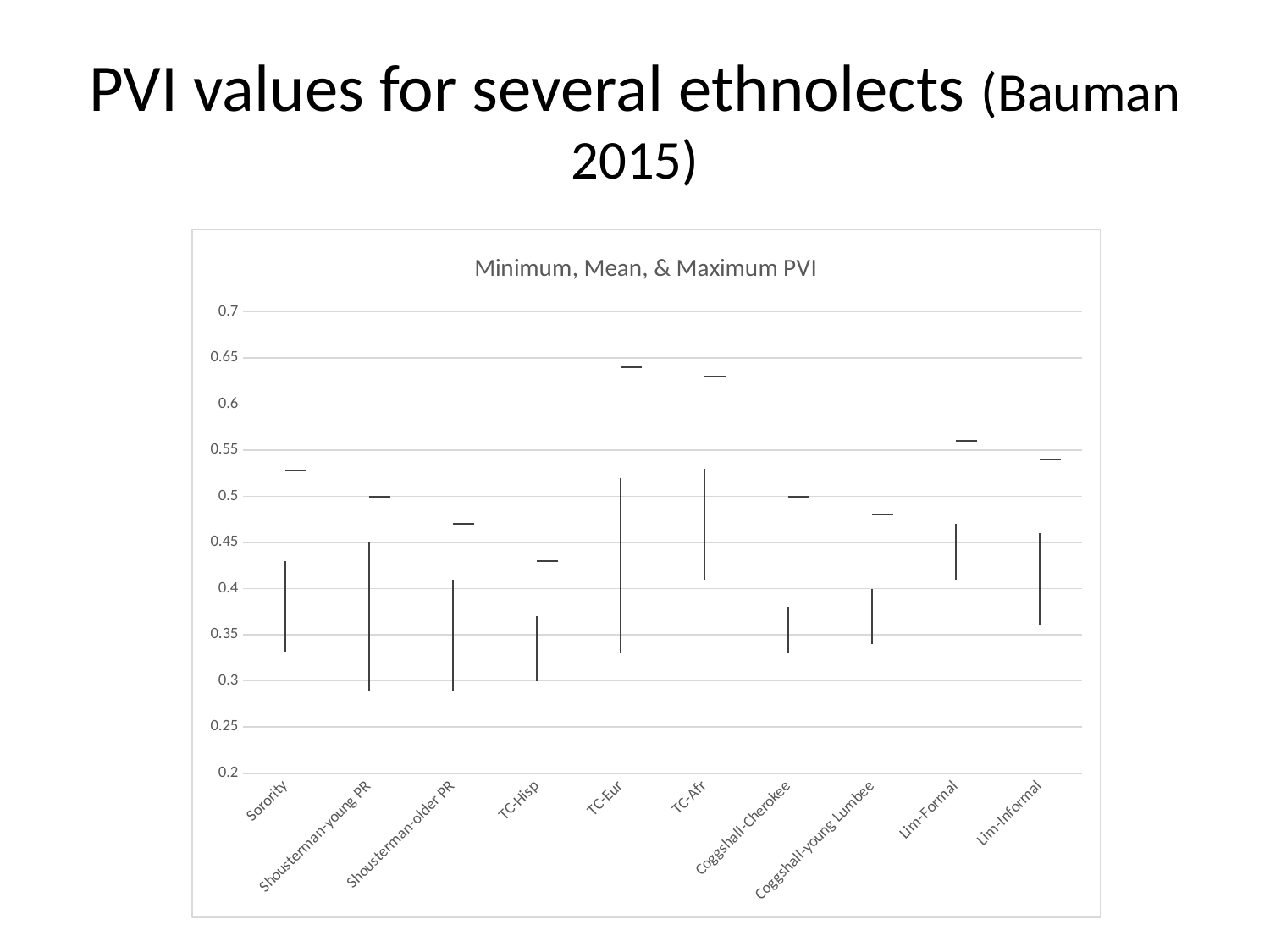
What is the minimum PVI value (bottom of the line) for TC-Hisp? 0.3 Which has the higher mean PVI marker, Sorority or Shousterman-older PR? Sorority Which category has the lowest mean PVI marker? TC-Hisp How many ethnolect categories are shown on the x axis? 10 What is the title of the chart? Minimum, Mean, & Maximum PVI Is the mean PVI marker for Coggshall-young Lumbee greater or less than 0.5? less What kind of chart is this? stock (high-low) chart Is the mean PVI marker for TC-Hisp greater or less than 0.45? less